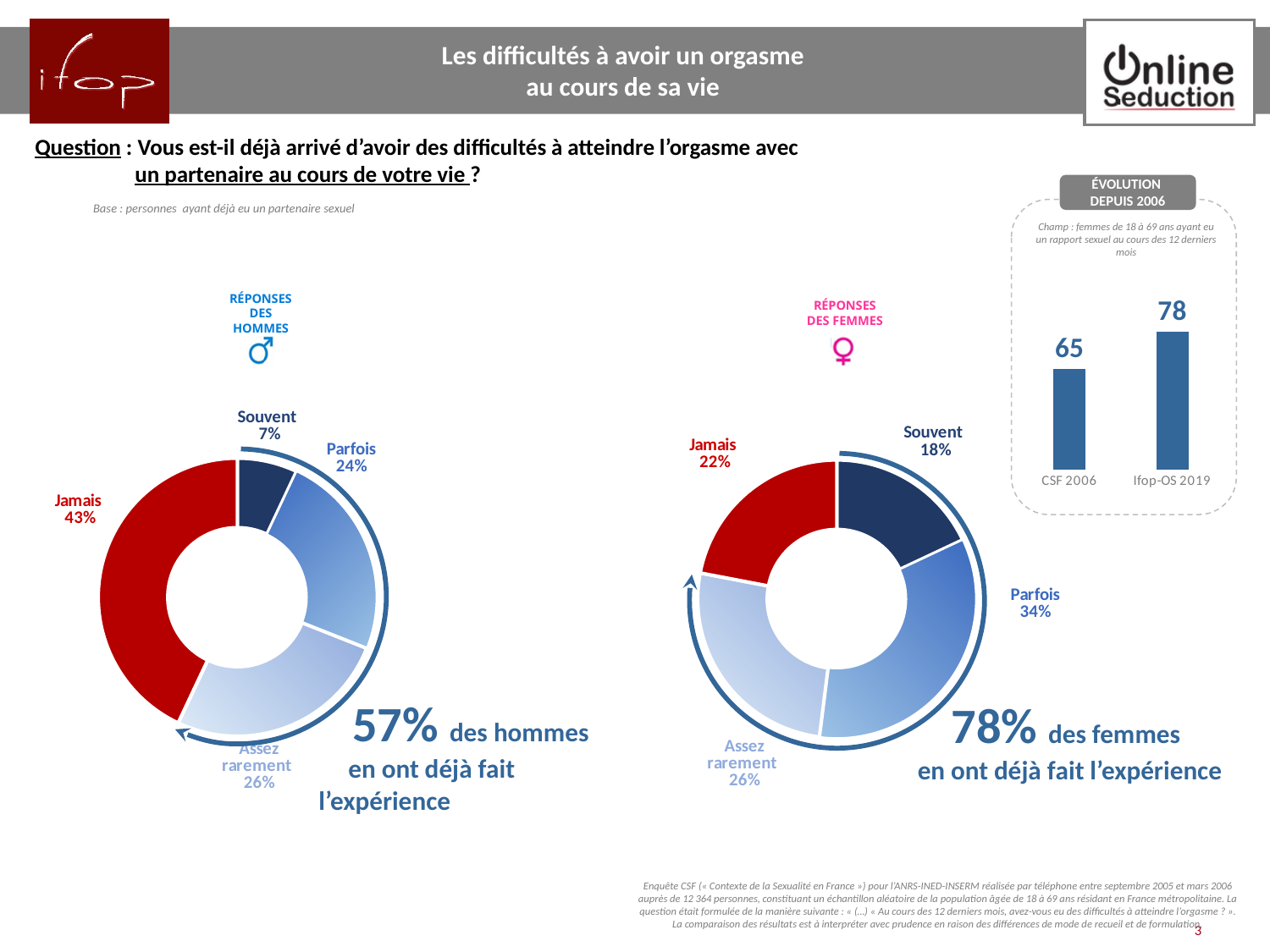
How many response categories does each donut chart show? 4 In the men's donut chart, what colour is the "Jamais" segment? Red In the women's donut chart, which response category has the largest share? Parfois In the men's donut chart, which response category has the smallest share? Souvent In the women's donut chart, what is the difference in percentage points between "Parfois" and "Jamais"? 12 In the "Évolution depuis 2006" bar chart, what is the difference between the Ifop-OS 2019 value and the CSF 2006 value? 13 Which is larger: the "Souvent" share for men or the "Souvent" share for women? Women (18%) In the "Évolution depuis 2006" bar chart, what is the value for Ifop-OS 2019? 78 In the women's donut chart (Réponses des femmes), what percentage answered "Parfois"? 34% What type of chart is used to show the men's and women's responses? Donut (pie) chart In the "Évolution depuis 2006" bar chart, do the values rise or fall from CSF 2006 to Ifop-OS 2019? Rise In the men's donut chart (Réponses des hommes), what percentage answered "Jamais"? 43%